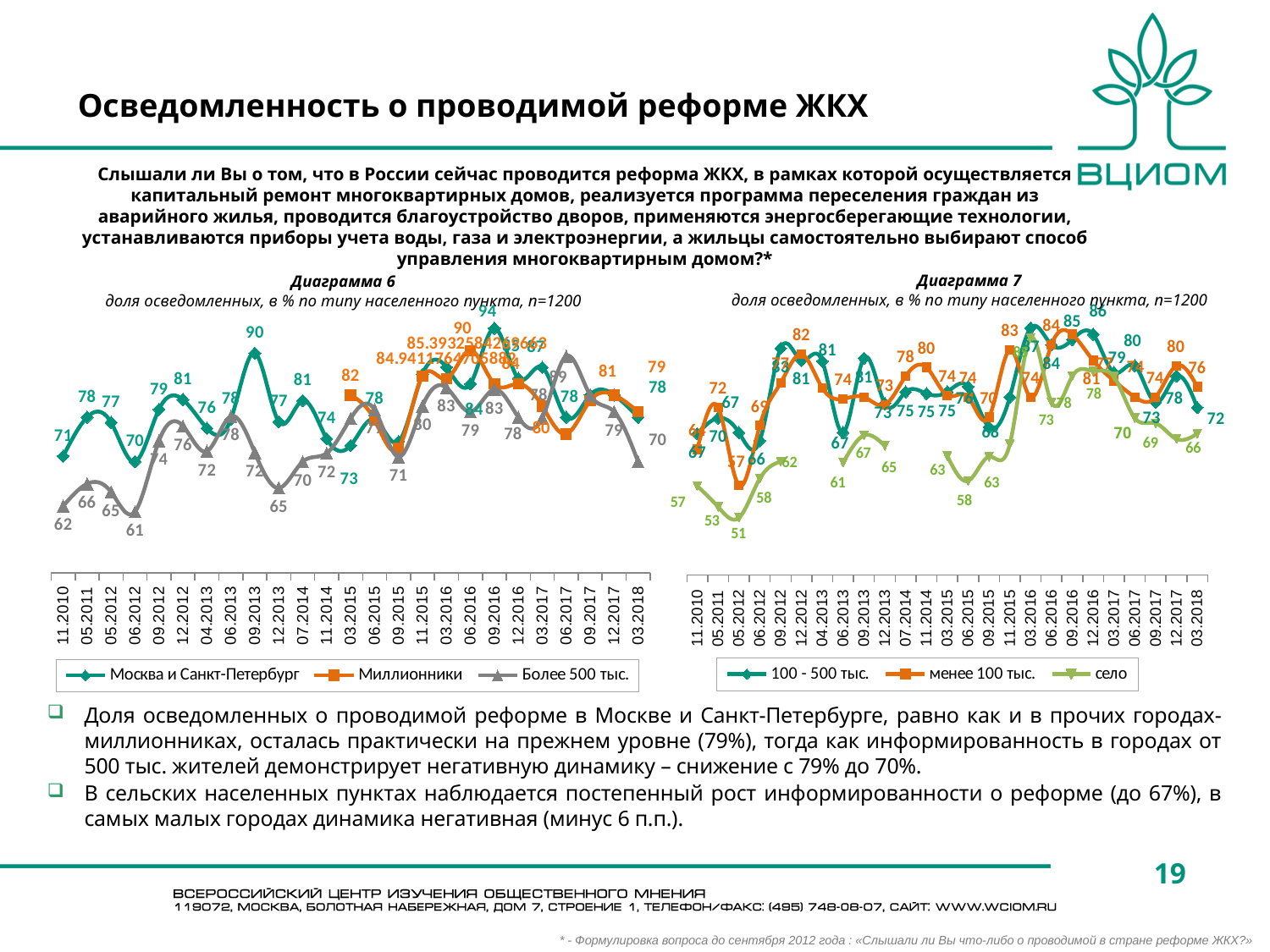
What kind of chart is Диаграмма 6? line chart In Диаграмма 7, what is the lowest value shown for село? 51 Which series are listed in the legend of Диаграмма 7? 100 - 500 тыс., менее 100 тыс., село How many series does the legend of Диаграмма 6 list? 3 In Диаграмма 6, what is the value for Более 500 тыс. at 03.2018? 70 In Диаграмма 7, what is the value for менее 100 тыс. at 03.2018? 76 In Диаграмма 6, what is the difference between Миллионники and Более 500 тыс. at 03.2018? 9 In Диаграмма 7, what is the value for село at 03.2018? 67 In Диаграмма 6, what is the highest value shown for Москва и Санкт-Петербург? 94 In Диаграмма 6, what is the value for Москва и Санкт-Петербург at 11.2010? 71 How many series does the legend of Диаграмма 7 list? 3 In Диаграмма 6, at 03.2018, which is larger: Миллионники or Более 500 тыс.? Миллионники